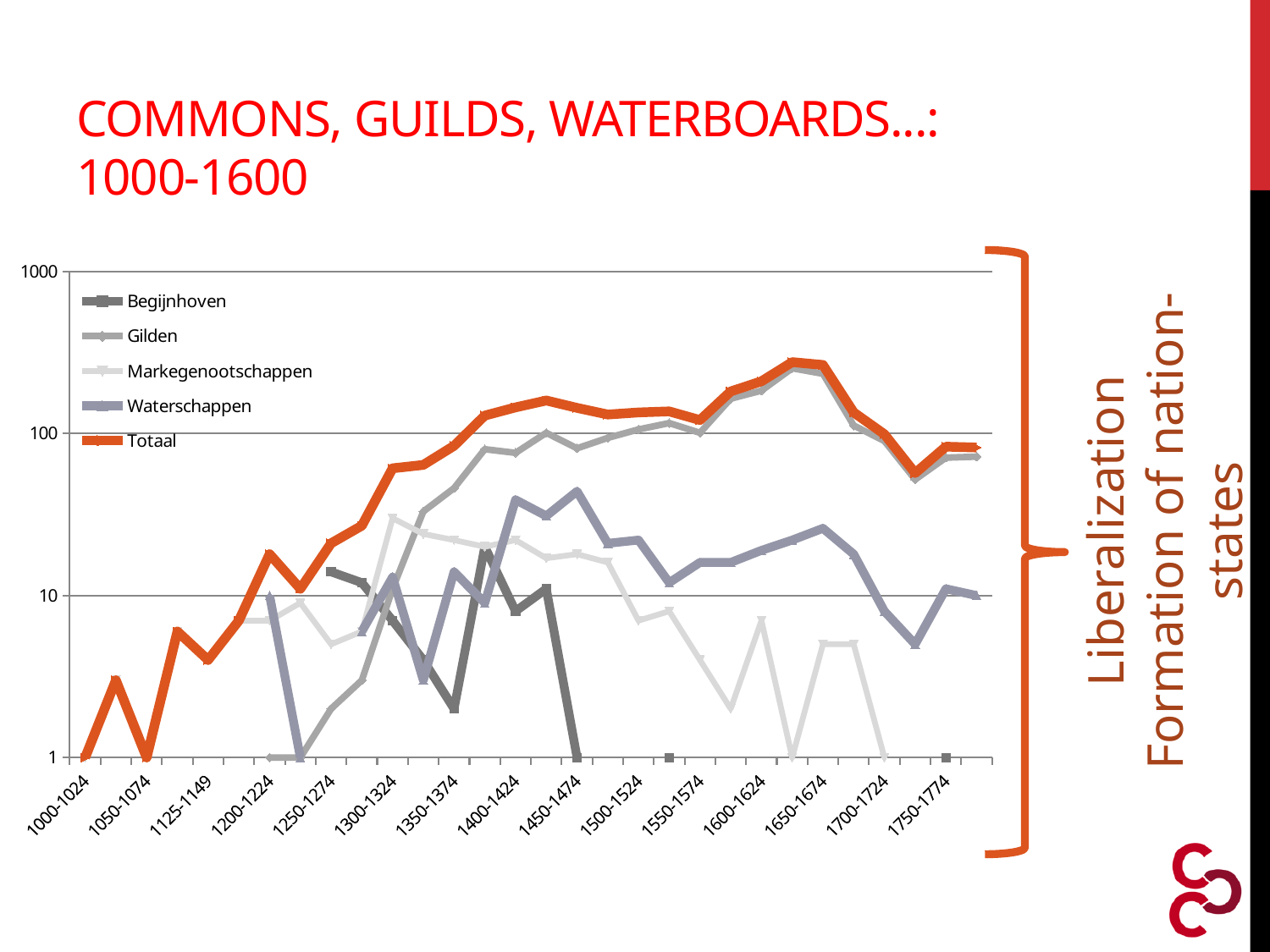
Which is larger in 1600-1624, Gilden or Markegenootschappen? Gilden Is the value for Totaal in 1000-1024 greater or less than 10? less Is the value for Totaal in 1650-1674 greater or less than 100? greater What is the title of the slide containing the chart? COMMONS, GUILDS, WATERBOARDS…: 1000-1600 Which series has the highest value in 1650-1674? Totaal What kind of chart is shown on the slide? line chart Does the Totaal series generally rise or fall from 1000-1024 to 1650-1674? rise How many series does the legend list? 5 Is the value for Gilden in 1450-1474 greater or less than 100? less Which series is drawn in orange? Totaal